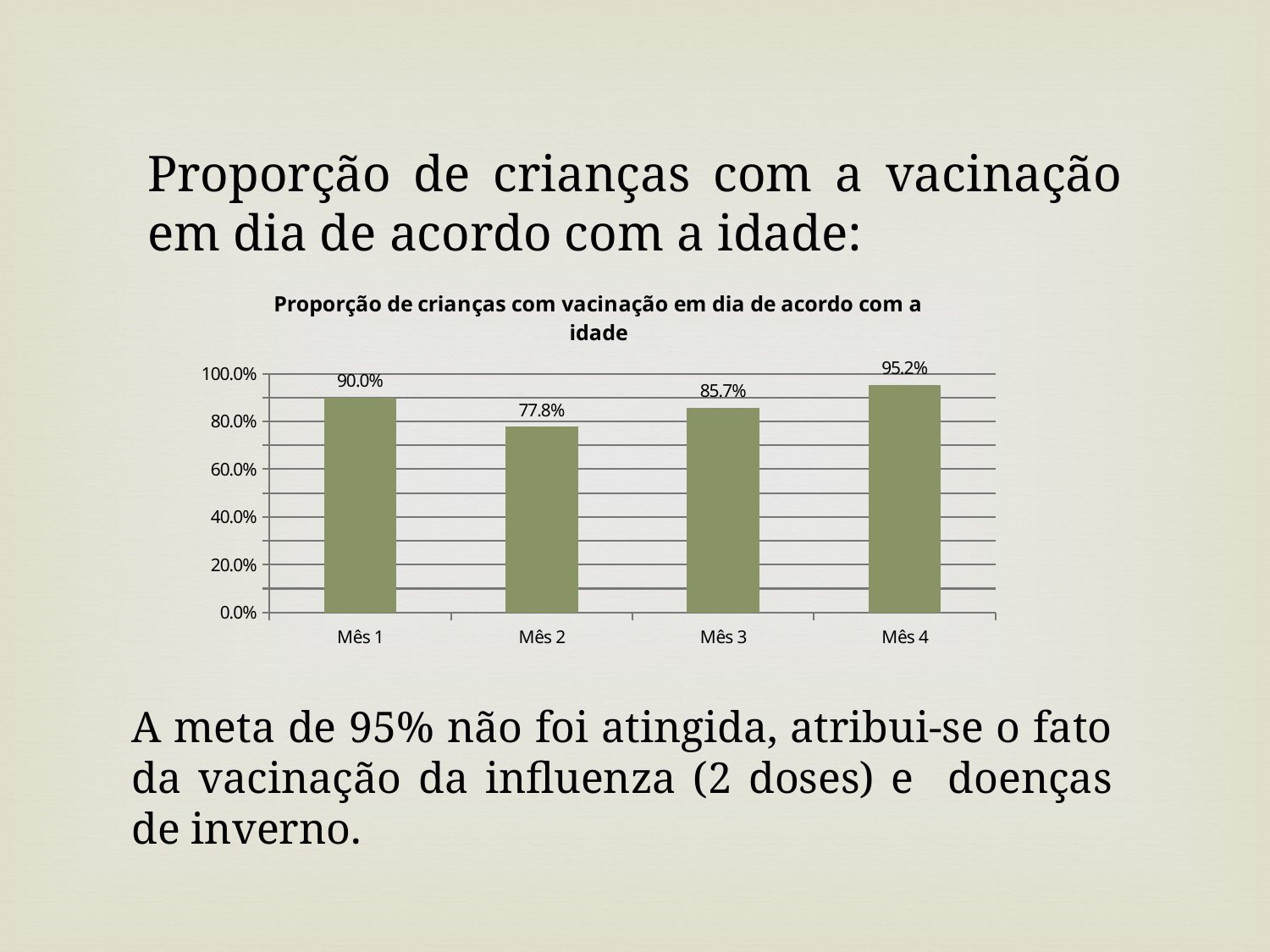
Which month has the highest value? Mês 4 Which month has the lowest value? Mês 2 What is the value for Mês 3? 85.7% What is the value for Mês 1? 90.0% What is the title of the chart? Proporção de crianças com vacinação em dia de acordo com a idade What is the value for Mês 4? 95.2% How many months are shown on the x axis? 4 What is the value for Mês 2? 77.8% Which is larger, the value for Mês 1 or the value for Mês 3? Mês 1 Is the value for Mês 2 greater or less than 80.0%? less What is the difference between the values for Mês 4 and Mês 2? 17.4% What kind of chart is shown on the slide? bar chart